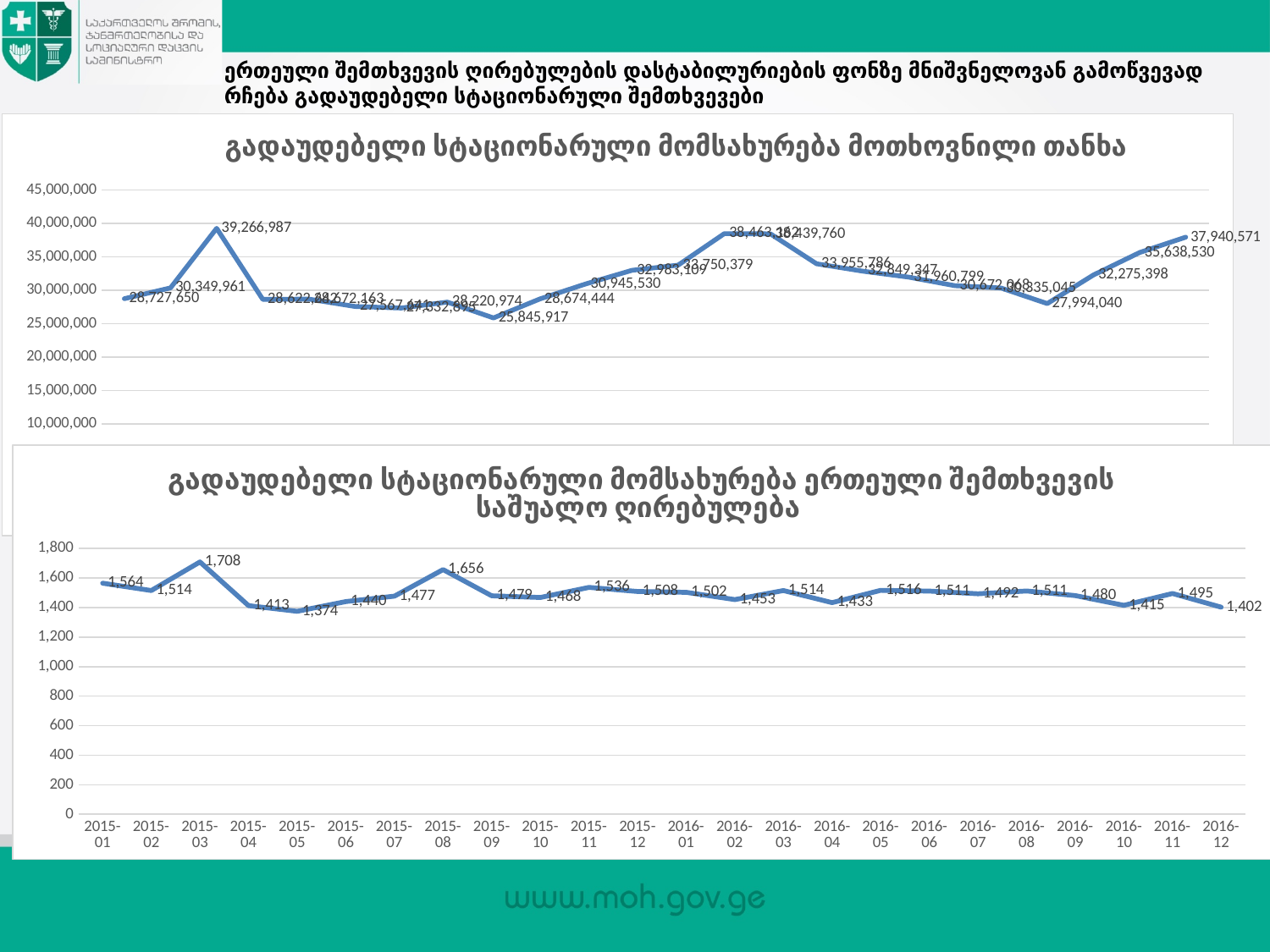
In the top chart (requested amount), what is the lowest labeled value? 25,845,917 In the top chart (requested amount), what is the value of the last (rightmost) data point? 37,940,571 What type of chart is the top chart (requested amount)? line chart In the bottom chart (average cost per case), which month has the lowest value? 2015-05 In the bottom chart (average cost per case), what is the value for 2015-01? 1,564 In the bottom chart (average cost per case), what is the difference between the values for 2015-03 and 2015-05? 334 In the top chart (requested amount), what is the highest labeled value? 39,266,987 In the bottom chart (average cost per case), what is the value for 2016-12? 1,402 In the bottom chart (average cost per case), how many monthly data points are plotted? 24 In the bottom chart (average cost per case), what is the value for 2015-03? 1,708 In the bottom chart (average cost per case), which month has the highest value? 2015-03 In the bottom chart (average cost per case), which is larger, the value for 2015-08 or the value for 2016-05? 2015-08